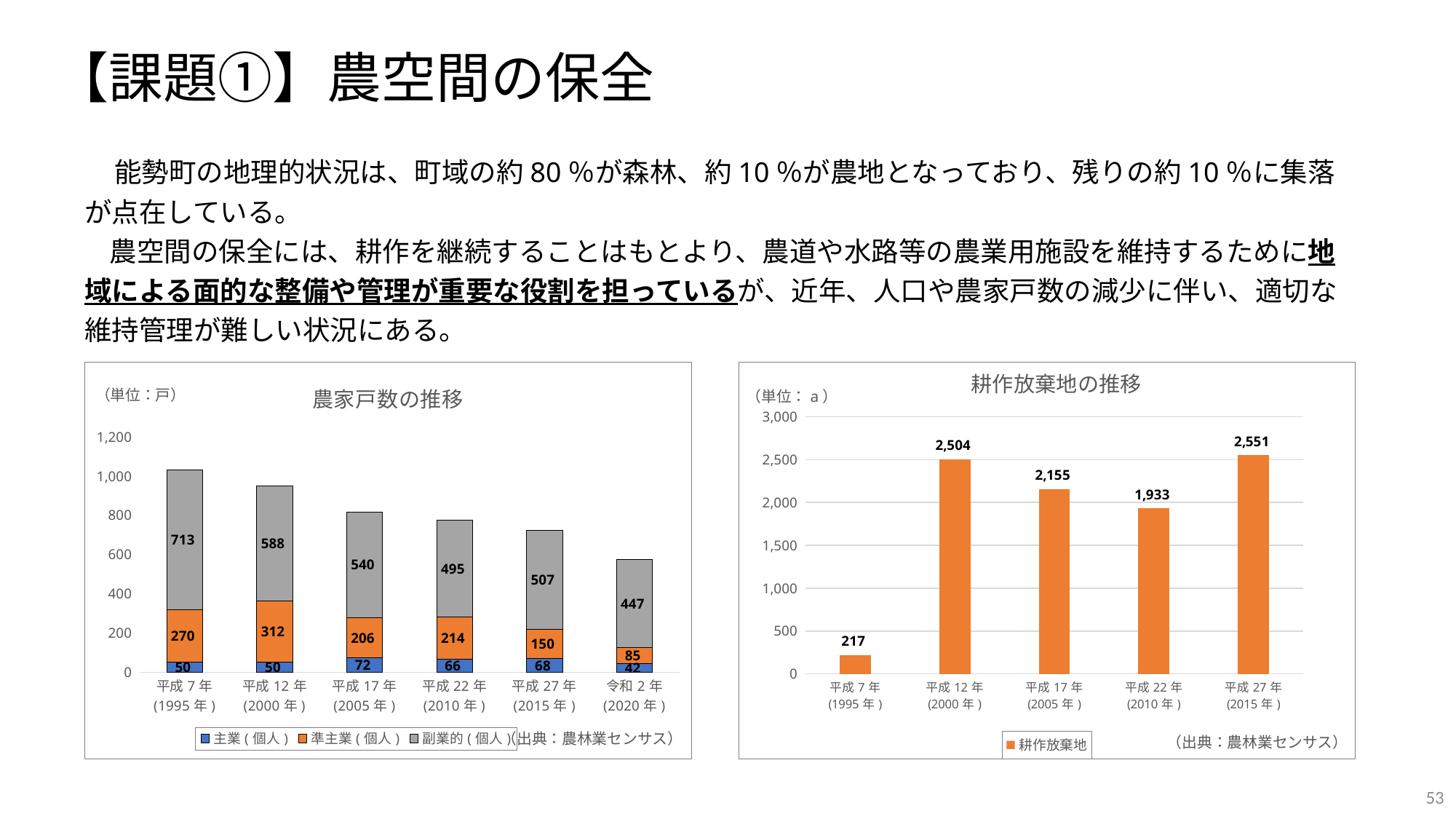
In the 農家戸数の推移 chart, what is the value of 準主業(個人) for 平成12年(2000年)? 312 In the 農家戸数の推移 chart, which year has the lowest value for 主業(個人)? 令和2年(2020年) In the 農家戸数の推移 chart, how many series does the legend list? 3 In the 農家戸数の推移 chart, do the total farm household numbers rise or fall from 平成7年 to 令和2年? fall In the 耕作放棄地の推移 chart, what is the difference between the values for 平成12年(2000年) and 平成7年(1995年)? 2,287 What kind of chart is the 耕作放棄地の推移 chart? bar chart In the 耕作放棄地の推移 chart, what is the value for 平成22年(2010年)? 1,933 In the 耕作放棄地の推移 chart, which year has the highest value? 平成27年(2015年) In the 農家戸数の推移 chart, what is the difference between the 準主業(個人) values for 平成12年(2000年) and 平成27年(2015年)? 162 In the 農家戸数の推移 chart, what is the value of 副業的(個人) for 平成7年(1995年)? 713 In the 耕作放棄地の推移 chart, how many years are plotted? 5 In the 農家戸数の推移 chart, what is the total of the stacked bar for 令和2年(2020年)? 574